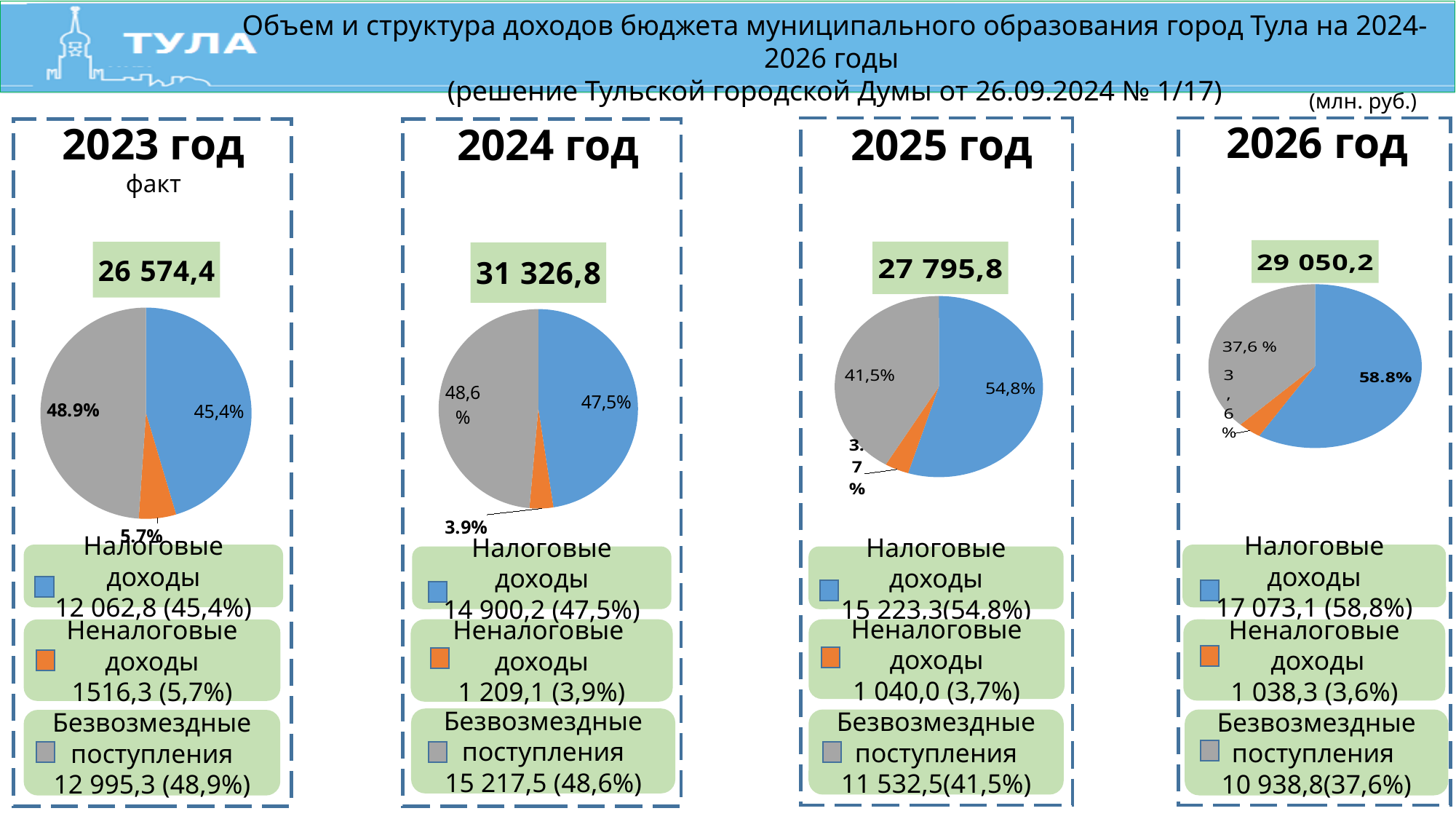
In the 2024 год pie chart, what share do Налоговые доходы make up? 47,5% In the 2026 год pie chart, what is the value for Безвозмездные поступления? 10 938,8 What kind of chart is used for the 2023 год panel? Pie chart Which colour represents Неналоговые доходы in the pie charts? Orange In the 2026 год pie chart, what is the difference between Налоговые доходы and Безвозмездные поступления? 6 134,3 In the 2026 год pie chart, which category has the smallest share? Неналоговые доходы In the 2025 год pie chart, which is larger: Налоговые доходы or Безвозмездные поступления? Налоговые доходы In the 2023 год pie chart, which category has the largest share? Безвозмездные поступления Across the four pie charts from 2023 to 2026, does the share of Налоговые доходы rise or fall? Rise What total value is shown above the 2025 год pie chart? 27 795,8 In the 2025 год pie chart, what is the value for Неналоговые доходы? 1 040,0 How many slices does the 2024 год pie chart have? 3